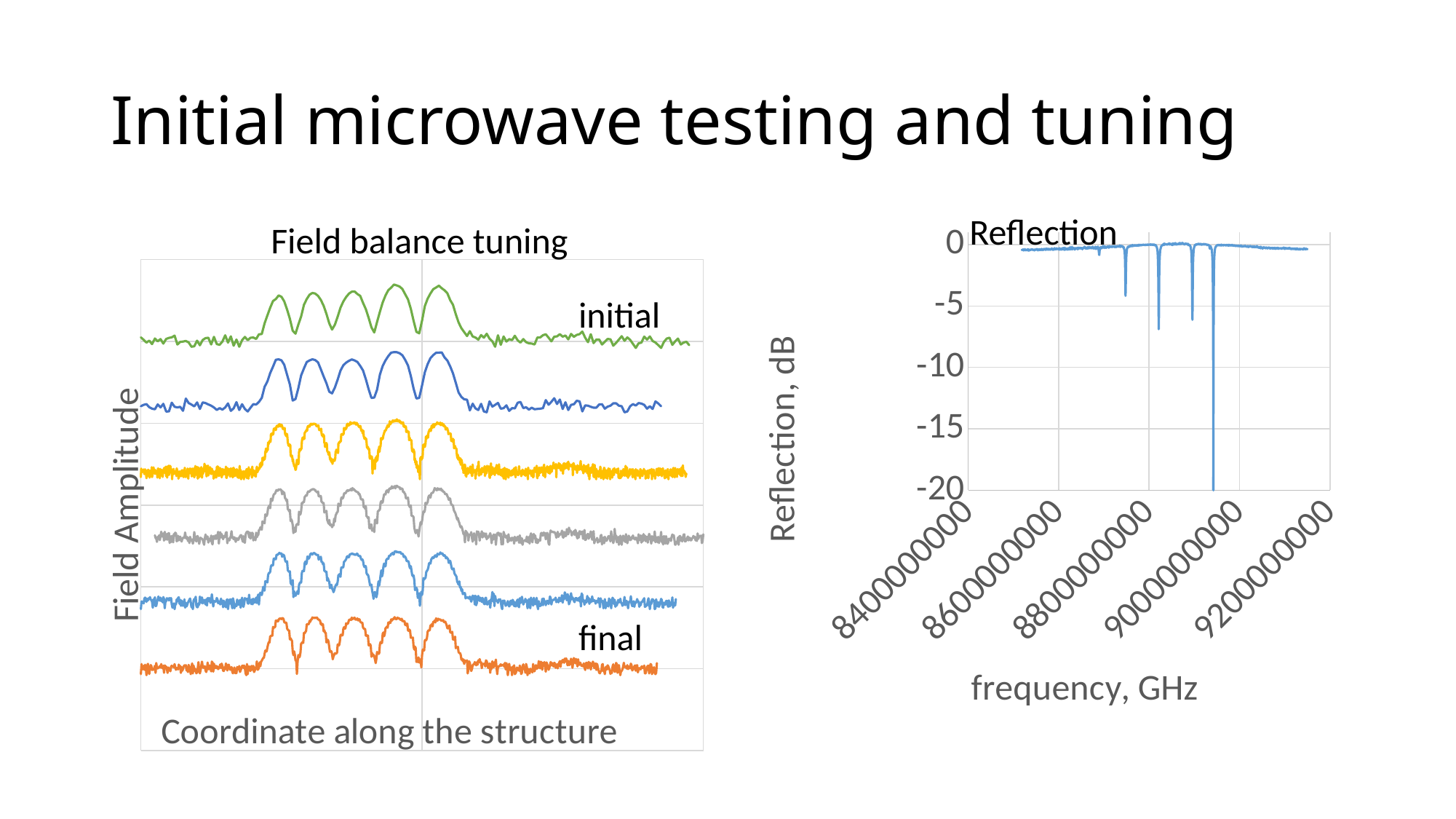
How many peaks does each trace on the 'Field balance tuning' chart show? 5 How many traces are plotted on the 'Field balance tuning' chart? 6 On the 'Reflection' chart, is the baseline level of the trace (away from the dips) greater or less than -5 dB? greater On the 'Reflection' chart, does the deepest dip occur closer to 9000000000 or to 8600000000 on the frequency axis? 9000000000 What kind of chart is the 'Reflection' chart on the right? line chart What is the x-axis title of the 'Field balance tuning' chart? Coordinate along the structure What kind of chart is the 'Field balance tuning' chart on the left? line chart What is the lowest value shown on the y axis of the 'Reflection' chart? -20 On the 'Reflection' chart, is the deepest dip greater or less than -15 dB? less On the 'Field balance tuning' chart, which trace is labelled 'initial', the top one or the bottom one? the top one What is the y-axis title of the 'Reflection' chart? Reflection, dB On the 'Field balance tuning' chart, what is the label of the bottom (orange) trace? final